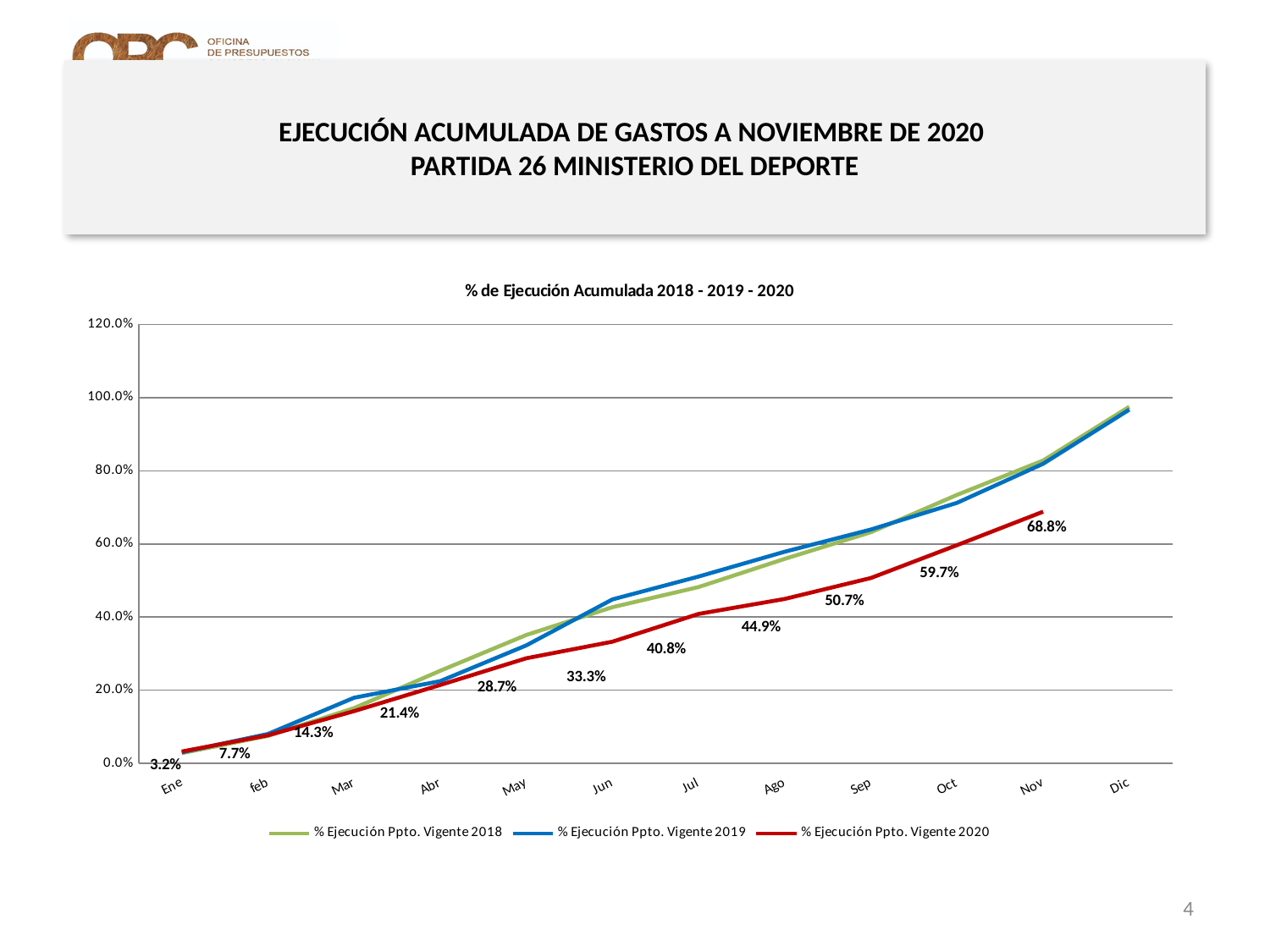
How many months are shown on the x axis? 12 What type of chart is shown on the slide? line chart What is the value of % Ejecución Ppto. Vigente 2020 for Ene? 3.2% What is the difference between the 2020 values for Sep and Ago? 5.8% What is the value of % Ejecución Ppto. Vigente 2020 for Nov? 68.8% How many series does the legend list? 3 Which is larger in Oct: % Ejecución Ppto. Vigente 2019 or % Ejecución Ppto. Vigente 2020? % Ejecución Ppto. Vigente 2019 What is the value of % Ejecución Ppto. Vigente 2020 for Jun? 33.3% What is the difference between the 2020 values for Nov and Oct? 9.1% Is the value for % Ejecución Ppto. Vigente 2019 in Dic greater or less than 80.0%? greater In which month does the % Ejecución Ppto. Vigente 2020 series reach its highest value? Nov Do the values of the % Ejecución Ppto. Vigente 2020 series rise or fall from Ene to Nov? rise